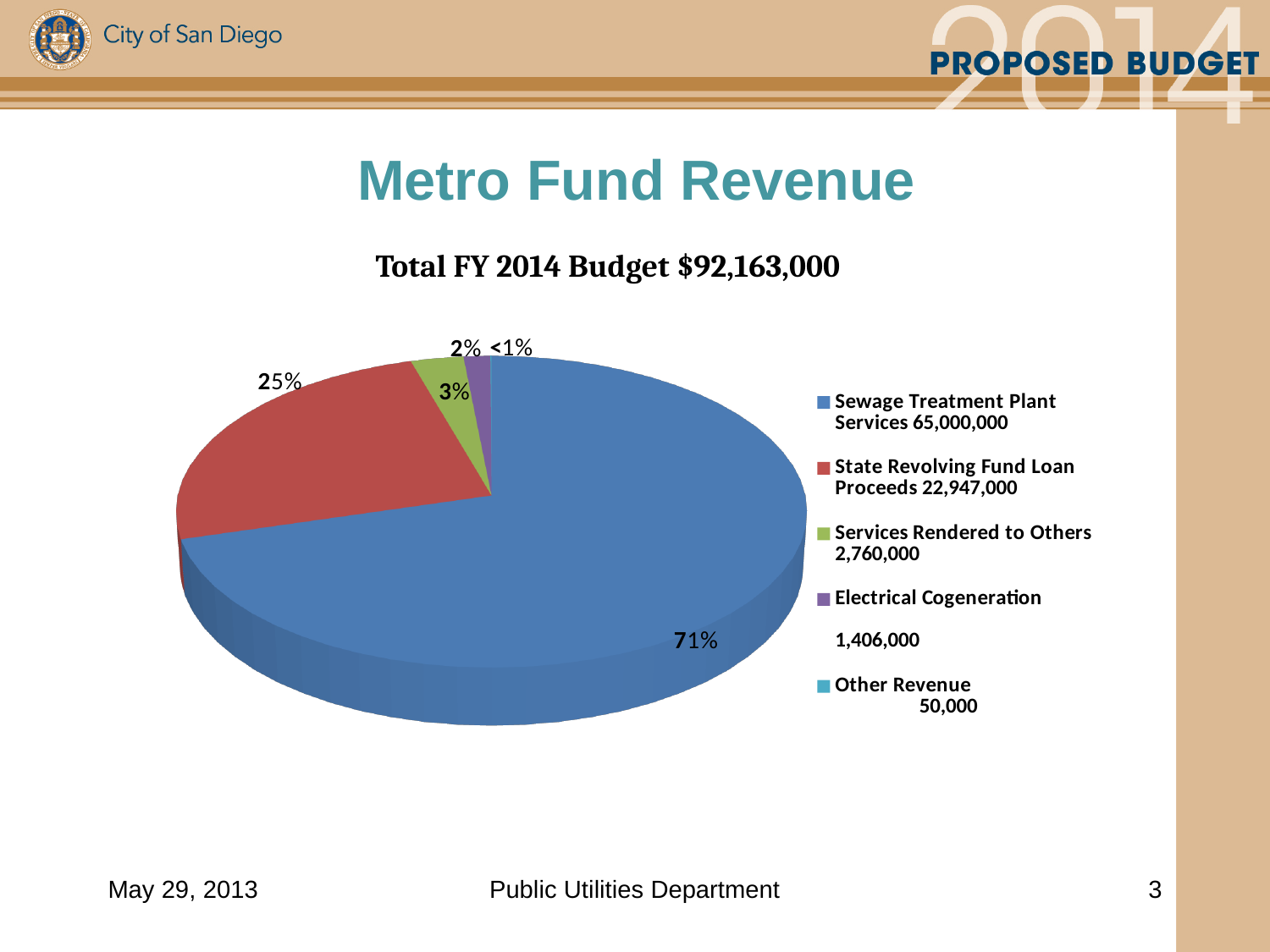
Which category has the smallest slice of the pie? Other Revenue What percentage of the pie is State Revolving Fund Loan Proceeds? 25% What is the chart's title? Total FY 2014 Budget $92,163,000 What percentage of the pie is Electrical Cogeneration? 2% What kind of chart is shown on the slide? Pie chart What value does the legend give for Electrical Cogeneration? 1,406,000 What value does the legend give for State Revolving Fund Loan Proceeds? 22,947,000 How many categories does the legend list? 5 What percentage of the pie is Services Rendered to Others? 3% Which is larger, Services Rendered to Others or Electrical Cogeneration? Services Rendered to Others Which category has the largest slice of the pie? Sewage Treatment Plant Services